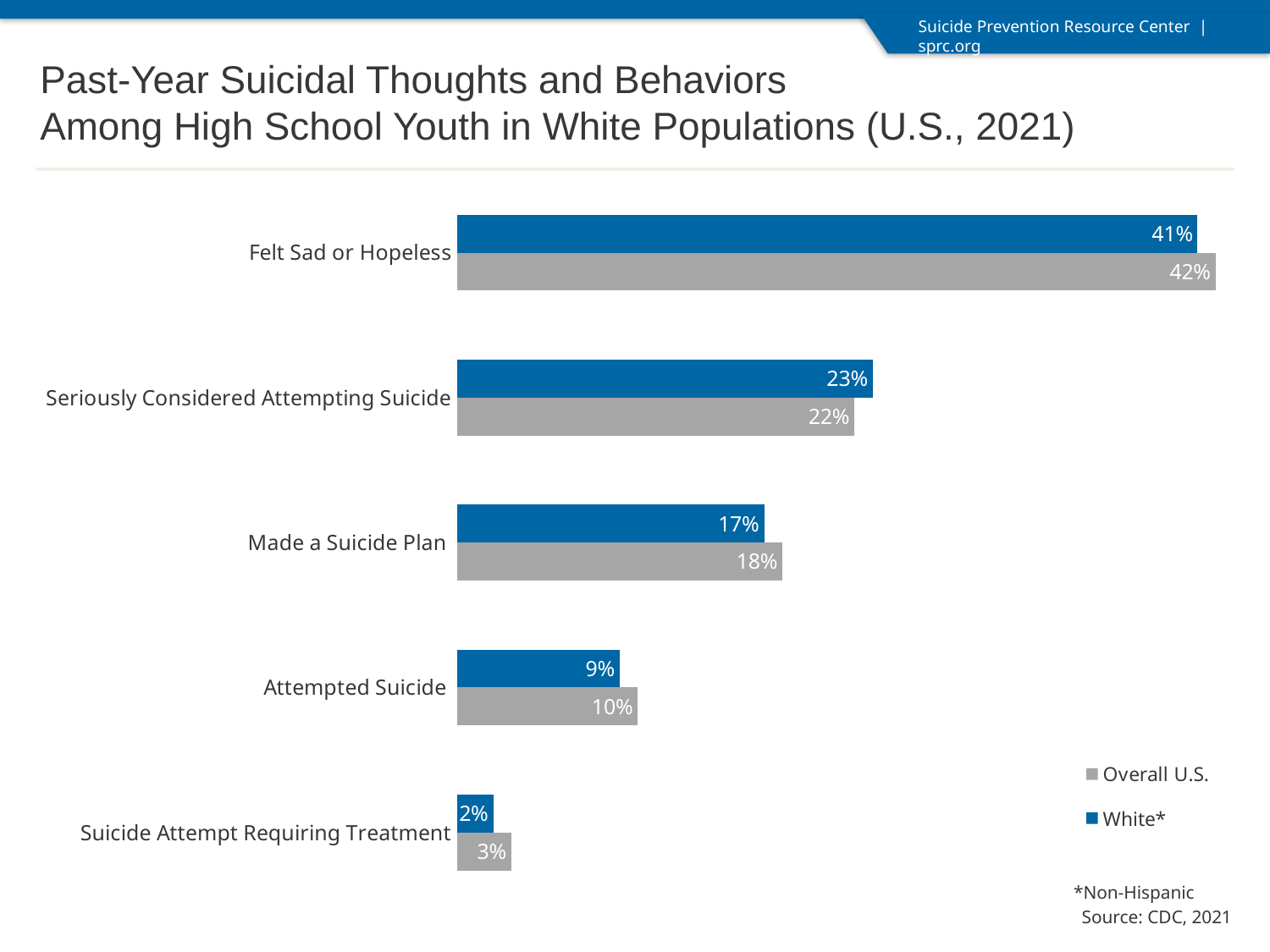
What is the value for White* for Felt Sad or Hopeless? 41% Which category has the highest value for the White* series? Felt Sad or Hopeless What is the difference between the Overall U.S. and White* values for Felt Sad or Hopeless? 1% How many categories are shown on the chart? 5 What is the difference between the White* values for Seriously Considered Attempting Suicide and Made a Suicide Plan? 6% Which category has the lowest value for the Overall U.S. series? Suicide Attempt Requiring Treatment For Seriously Considered Attempting Suicide, which is larger: the White* value or the Overall U.S. value? White* How many series does the legend list? 2 What is the value for White* for Attempted Suicide? 9% What kind of chart is shown on the slide? Bar chart What is the value for Overall U.S. for Made a Suicide Plan? 18% What is the value for Overall U.S. for Seriously Considered Attempting Suicide? 22%